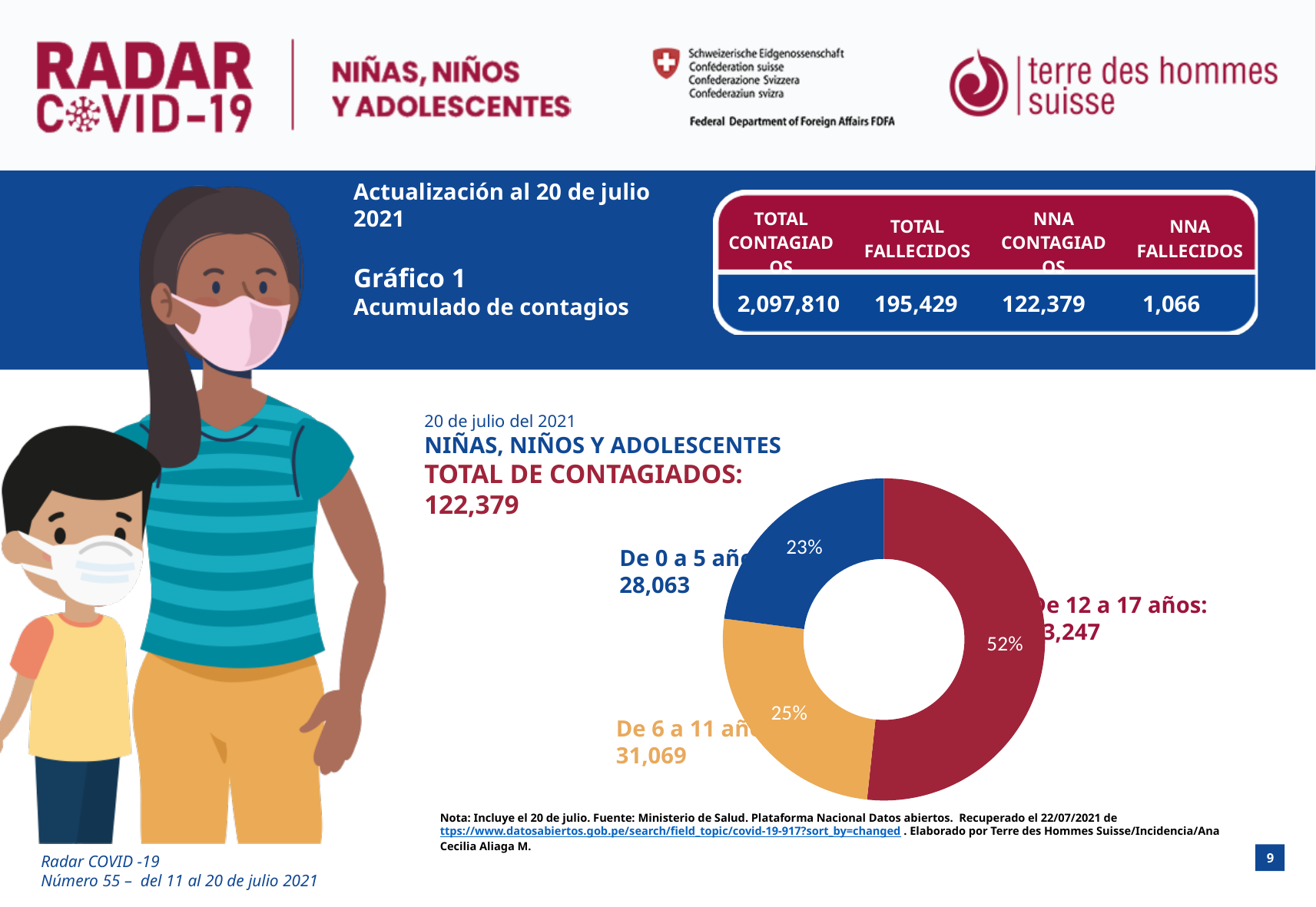
What is the difference in contagiados between 'De 6 a 11 años' and 'De 0 a 5 años'? 3,006 Which has more contagiados, 'De 6 a 11 años' or 'De 0 a 5 años'? De 6 a 11 años What is the number of contagiados for 'De 0 a 5 años'? 28,063 How many age-group slices does the donut chart have? 3 What percentage of the donut chart corresponds to 'De 12 a 17 años'? 52% What kind of chart is shown on the slide? donut chart What percentage of the donut chart corresponds to 'De 6 a 11 años'? 25% What total de contagiados is stated in the chart heading? 122,379 Which age group has the smallest share of the donut chart? De 0 a 5 años What is the number of contagiados for 'De 6 a 11 años'? 31,069 Which age group has the largest share of the donut chart? De 12 a 17 años What percentage of the donut chart corresponds to 'De 0 a 5 años'? 23%